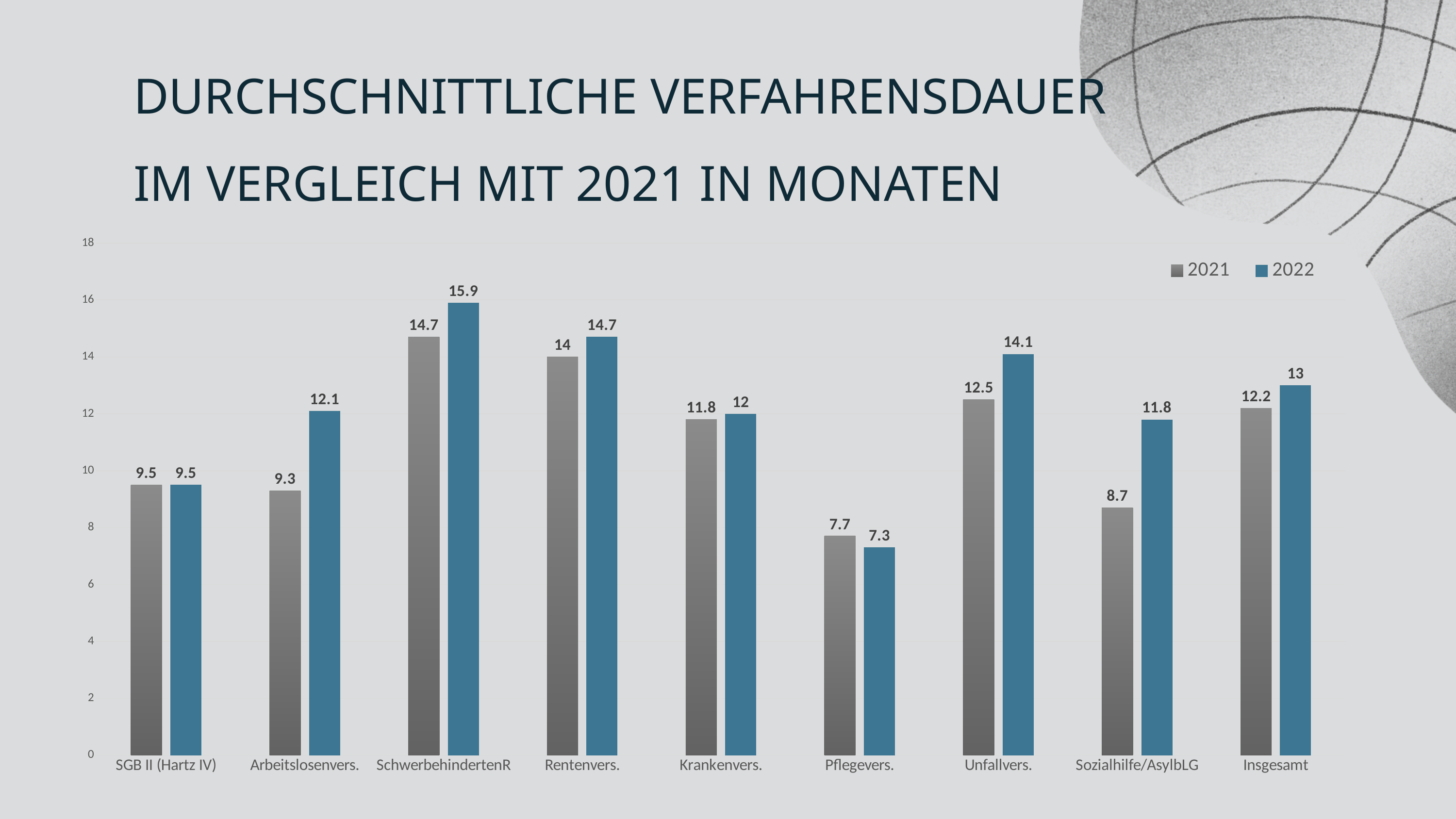
What is the difference between the 2022 and 2021 values for Arbeitslosenvers.? 2.8 How many categories are shown on the x axis? 9 For Pflegevers., which is larger, the 2021 value or the 2022 value? 2021 Which series is shown in blue? 2022 What is the 2021 value for Sozialhilfe/AsylbLG? 8.7 Is the 2022 value for Unfallvers. greater or less than 12? greater Which category has the highest 2022 value? SchwerbehindertenR What kind of chart is shown on the slide? bar chart How many series does the legend list? 2 What is the 2022 value for Insgesamt? 13 Which category has the lowest 2021 value? Pflegevers. What is the 2022 value for SchwerbehindertenR? 15.9